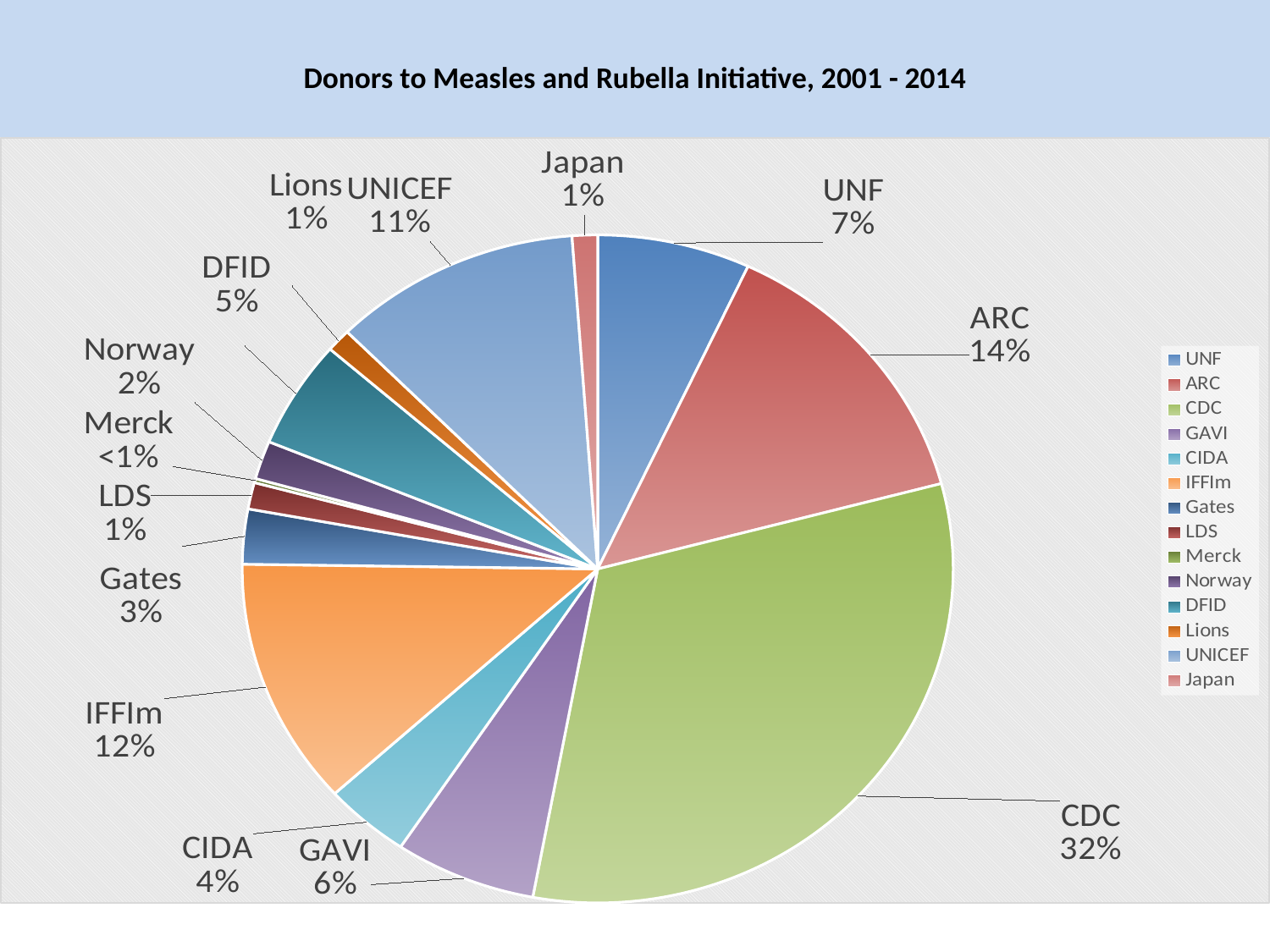
What type of chart is shown on the slide? Pie chart What percentage is shown for ARC? 14% How many donors are listed in the legend? 14 What is the title of the chart? Donors to Measles and Rubella Initiative, 2001 - 2014 Which donor has the largest slice of the pie? CDC What is the difference in percentage points between CDC and ARC? 18 Which is larger, the share for UNICEF or the share for IFFIm? IFFIm What share of the pie does CDC account for? 32% What percentage is shown for DFID? 5% What percentage is shown for Merck? <1% Which donor has the smallest slice of the pie? Merck What percentage is shown for IFFIm? 12%